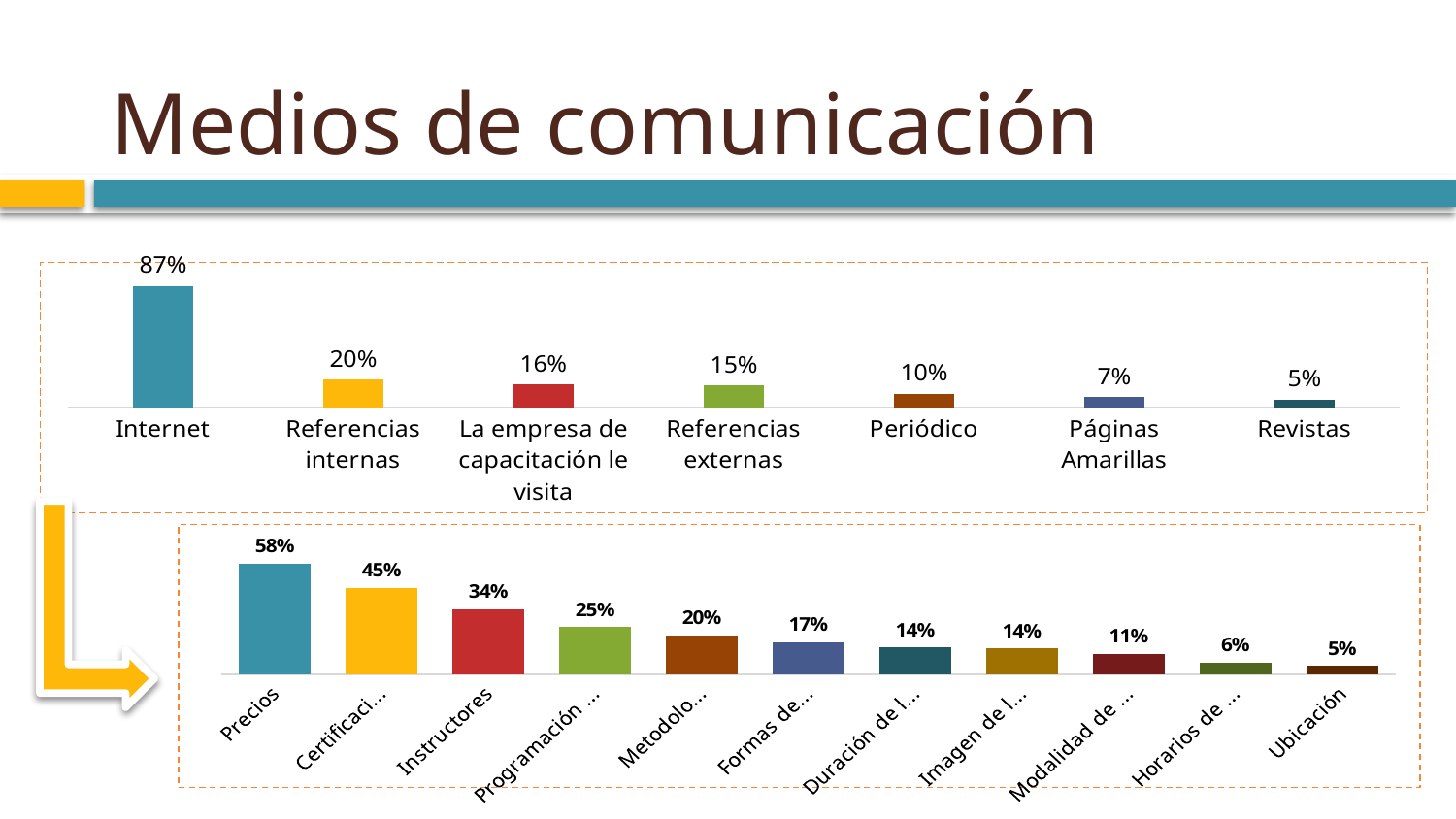
In the top chart, what is the value for Referencias externas? 15% In the top chart, what is the value for Internet? 87% In the top chart, what is the difference between Internet and Referencias internas? 67% How many categories are shown in the bottom chart? 11 In the bottom chart, what is the value for Instructores? 34% In the bottom chart, what is the difference between Precios and Ubicación? 53% How many categories are shown in the top chart? 7 In the bottom chart, what is the value for Precios? 58% In the top chart, which is larger, Periódico or Páginas Amarillas? Periódico In the bottom chart, which category has the highest value? Precios In the top chart, which category has the lowest value? Revistas What kind of chart is the top chart? Bar chart